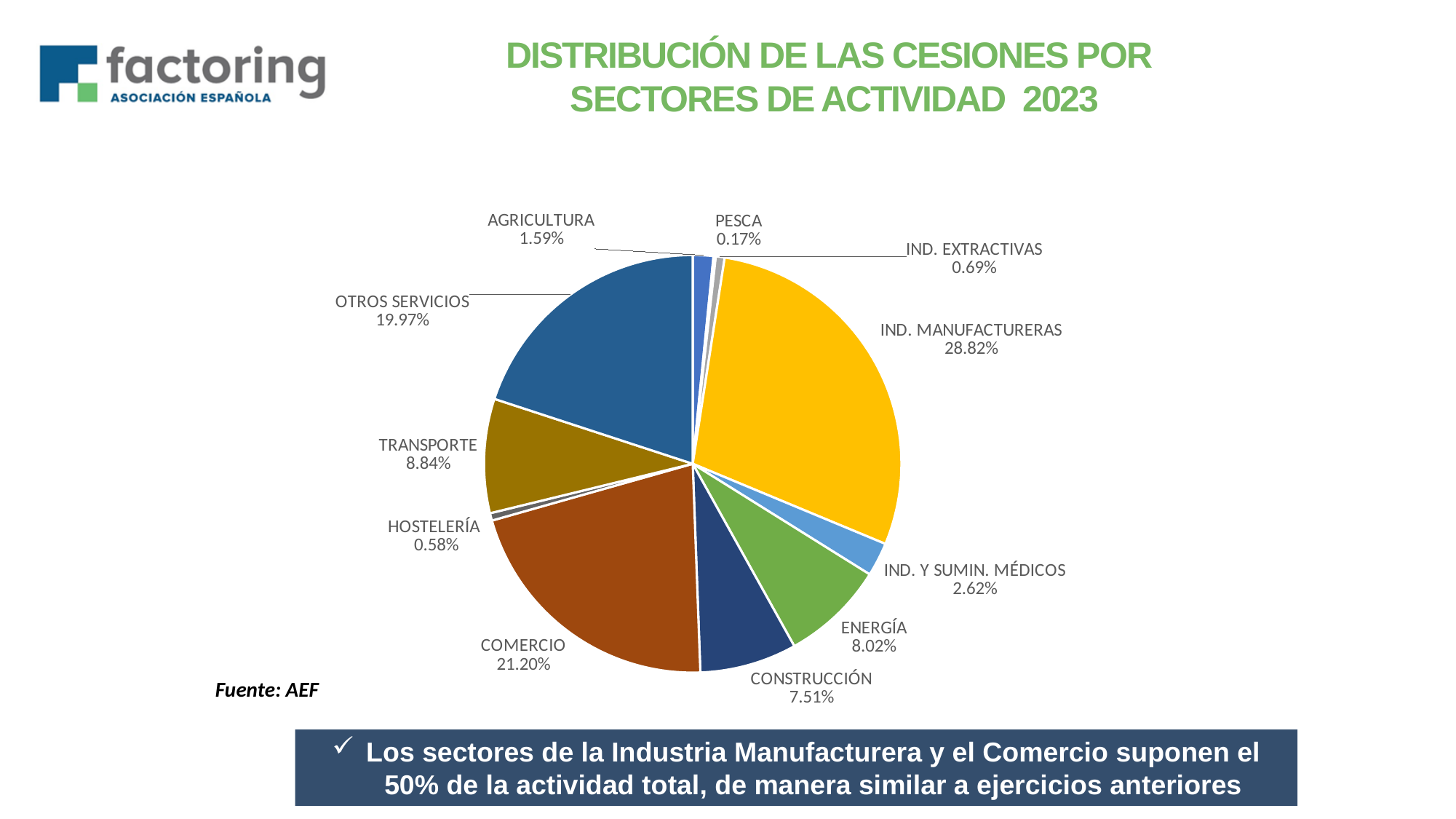
How many sectors are shown in the pie chart? 11 What is the share for IND. MANUFACTURERAS in the pie chart? 28.82% What is the title of the chart on the slide? DISTRIBUCIÓN DE LAS CESIONES POR SECTORES DE ACTIVIDAD 2023 What is the difference in percentage points between TRANSPORTE and ENERGÍA? 0.82 Which sector has the largest share in the pie chart? IND. MANUFACTURERAS What type of chart is shown on the slide? Pie chart Which sector has the smallest share in the pie chart? PESCA Which has a larger share, OTROS SERVICIOS or COMERCIO? COMERCIO What share does HOSTELERÍA have in the chart? 0.58% What is the difference in percentage points between IND. MANUFACTURERAS and COMERCIO? 7.62 What percentage does COMERCIO represent in the pie chart? 21.20% What is the value shown for TRANSPORTE? 8.84%